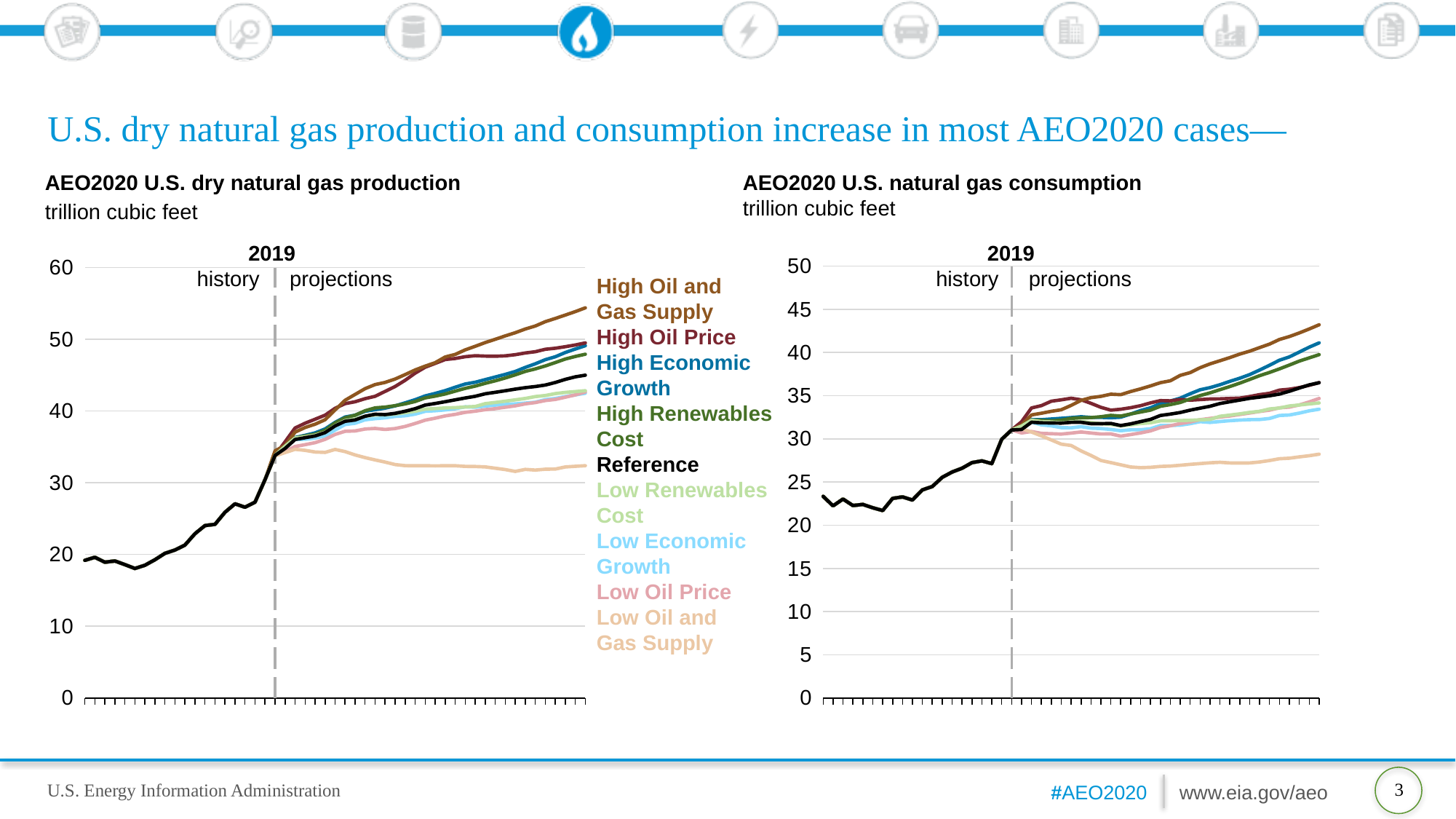
In the AEO2020 U.S. dry natural gas production chart, which case has the highest value at the end of the projection period? High Oil and Gas Supply In the AEO2020 U.S. natural gas consumption chart, which case has the highest value at the end of the projection period? High Oil and Gas Supply In the AEO2020 U.S. dry natural gas production chart, is the High Oil and Gas Supply value at the end of the projection greater or less than 50? greater How many cases (series) does the legend between the two charts list? 9 In the AEO2020 U.S. natural gas consumption chart, which is larger at the end of the projection: High Economic Growth or Low Economic Growth? High Economic Growth In the AEO2020 U.S. dry natural gas production chart, which case has the lowest value at the end of the projection period? Low Oil and Gas Supply In the AEO2020 U.S. dry natural gas production chart, does the Reference case rise or fall over the projection period? rise What unit is used on both charts? trillion cubic feet In the AEO2020 U.S. natural gas consumption chart, is the Reference case value at the end of the projection greater or less than 40? less In the AEO2020 U.S. natural gas consumption chart, which case has the lowest value at the end of the projection period? Low Oil and Gas Supply What kind of chart is the AEO2020 U.S. dry natural gas production chart? line chart In the AEO2020 U.S. dry natural gas production chart, is the Low Oil and Gas Supply value at the end of the projection greater or less than 40? less